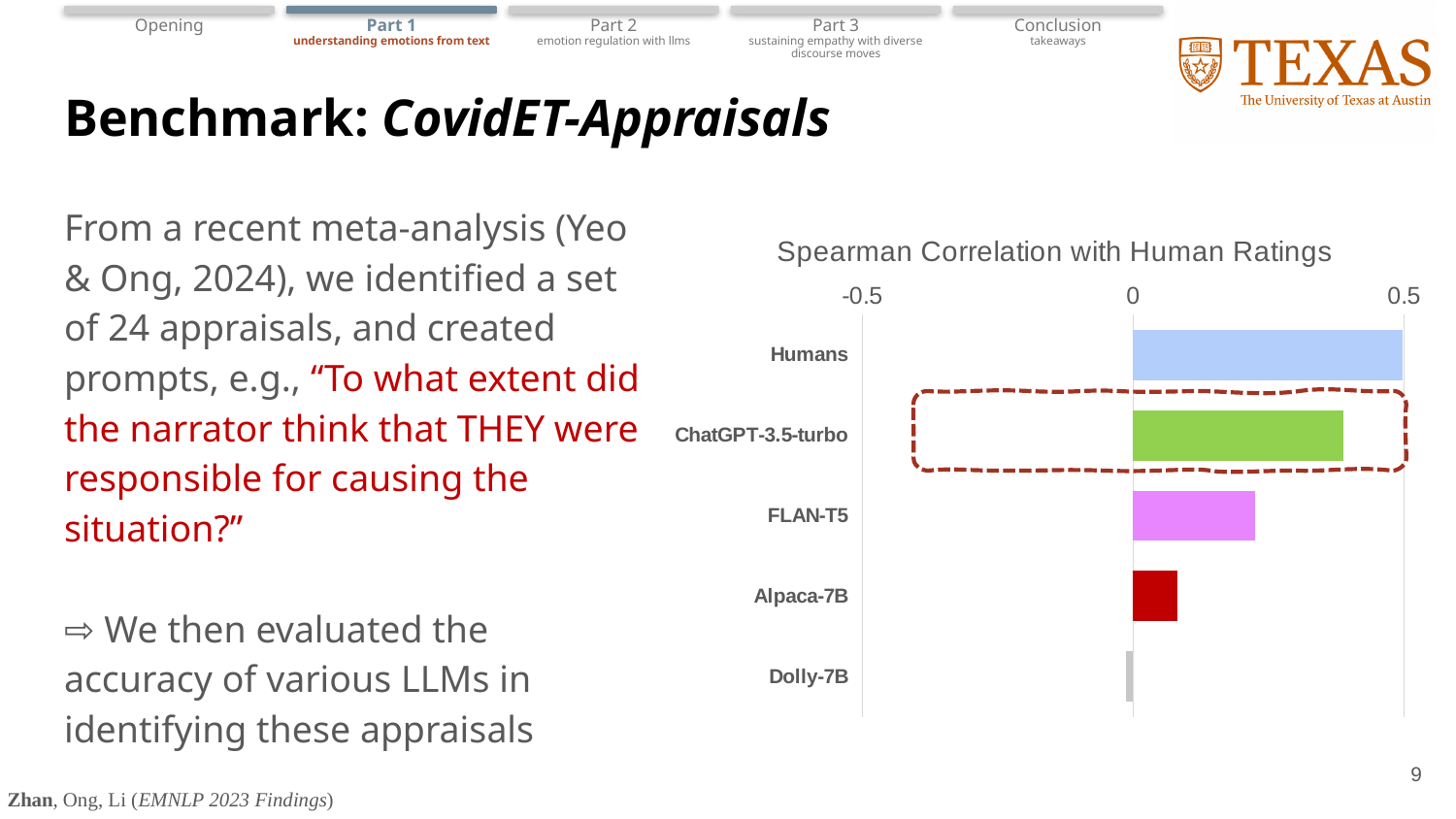
Which category has the lowest Spearman correlation with human ratings? Dolly-7B Is the value for FLAN-T5 greater or less than 0.5? less Which category is listed at the bottom of the chart? Dolly-7B What kind of chart is shown on the slide? bar chart Which has a higher Spearman correlation, Alpaca-7B or FLAN-T5? FLAN-T5 Is the value for Alpaca-7B greater or less than 0.5? less Is the value for ChatGPT-3.5-turbo greater or less than 0? greater Which category has the highest Spearman correlation with human ratings? Humans Which category's bar is highlighted with a dashed red outline? ChatGPT-3.5-turbo What is the title of the chart? Spearman Correlation with Human Ratings Which has a higher Spearman correlation, ChatGPT-3.5-turbo or FLAN-T5? ChatGPT-3.5-turbo How many categories are plotted in the chart? 5